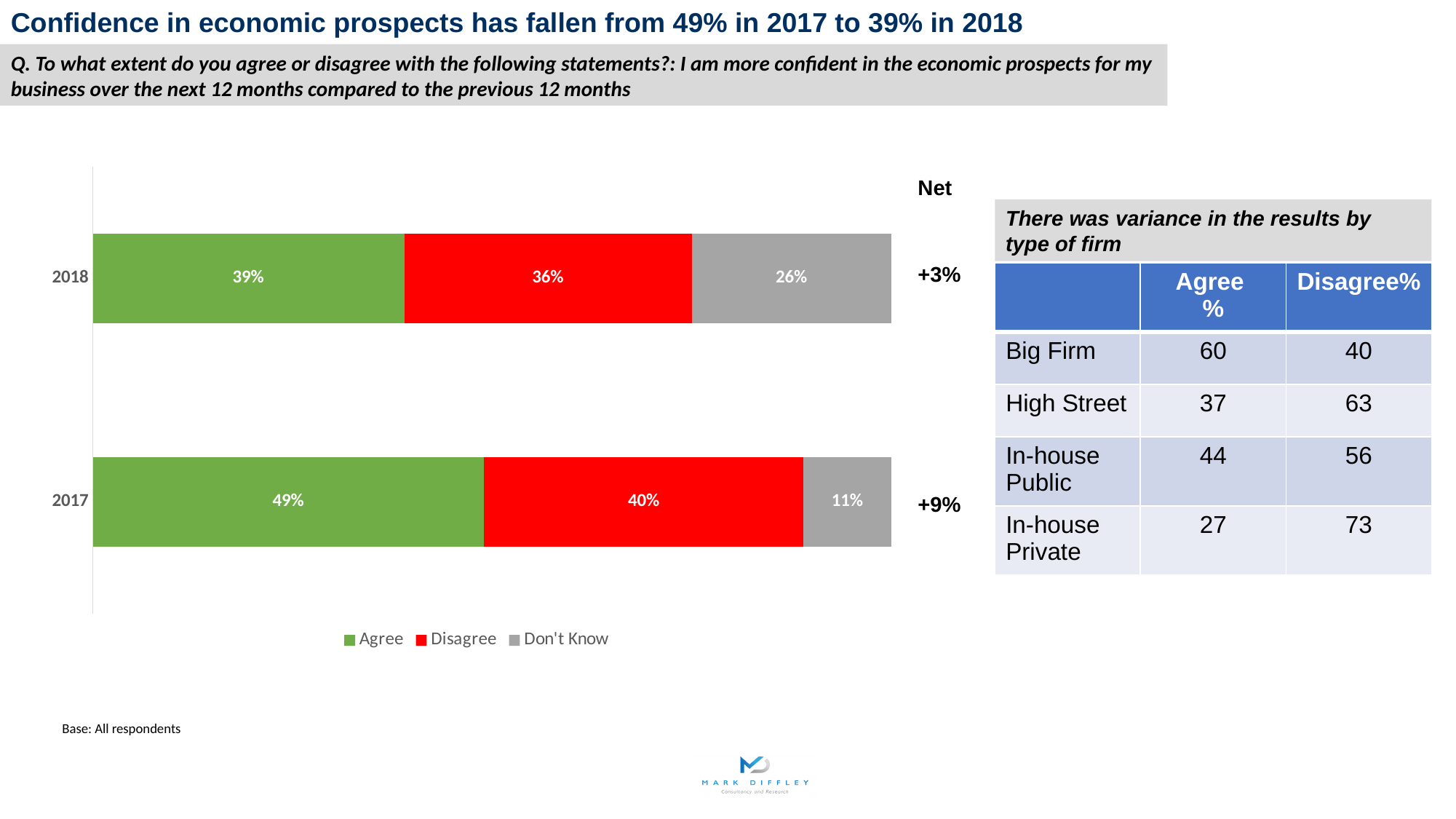
What percentage of respondents agreed in 2018? 39% How many series does the legend list? 3 Which year has the higher Agree percentage? 2017 By how many percentage points did the Agree share fall from 2017 to 2018? 10 How many years are shown in the chart? 2 What is the difference between the Disagree shares in 2017 and 2018? 4 What is the Don't Know share for 2018? 26% Which year has the higher Don't Know percentage? 2018 What type of chart is shown? Stacked bar chart What is the Don't Know share for 2017? 11% Which colour represents Disagree in the chart? Red What percentage of respondents disagreed in 2017? 40%